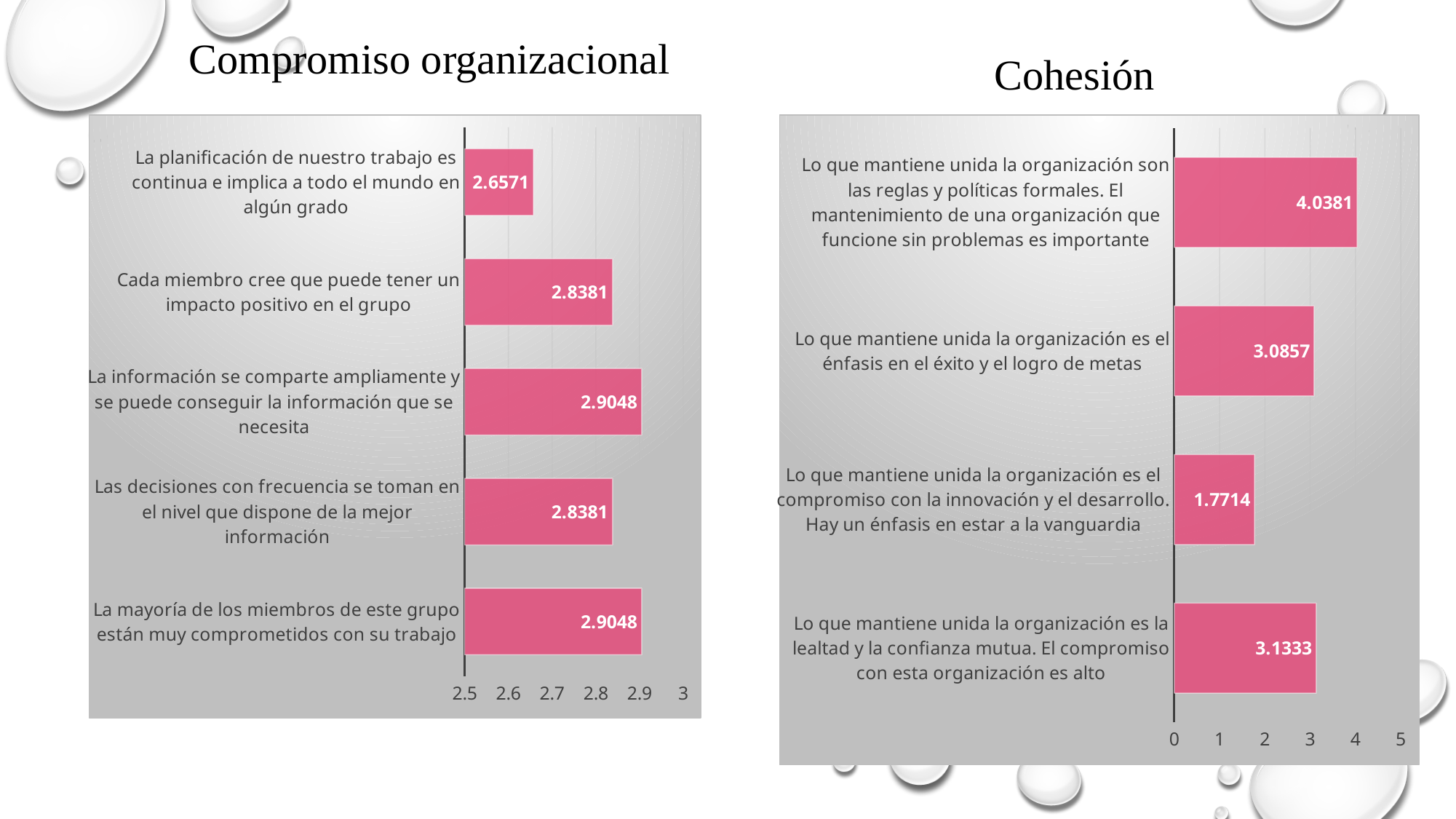
In the 'Cohesión' chart, what is the value for 'Lo que mantiene unida la organización son las reglas y políticas formales. El mantenimiento de una organización que funcione sin problemas es importante'? 4.0381 In the 'Cohesión' chart, which is larger: the value for 'Lo que mantiene unida la organización es la lealtad y la confianza mutua. El compromiso con esta organización es alto' or the value for 'Lo que mantiene unida la organización es el énfasis en el éxito y el logro de metas'? Lo que mantiene unida la organización es la lealtad y la confianza mutua. El compromiso con esta organización es alto In the 'Compromiso organizacional' chart, what is the value for 'Cada miembro cree que puede tener un impacto positivo en el grupo'? 2.8381 In the 'Cohesión' chart, how many categories are shown? 4 In the 'Cohesión' chart, which category has the highest value? Lo que mantiene unida la organización son las reglas y políticas formales. El mantenimiento de una organización que funcione sin problemas es importante In the 'Compromiso organizacional' chart, which category has the lowest value? La planificación de nuestro trabajo es continua e implica a todo el mundo en algún grado In the 'Cohesión' chart, which category has the lowest value? Lo que mantiene unida la organización es el compromiso con la innovación y el desarrollo. Hay un énfasis en estar a la vanguardia What type of chart is the 'Cohesión' chart? Bar chart In the 'Compromiso organizacional' chart, what is the value for 'La planificación de nuestro trabajo es continua e implica a todo el mundo en algún grado'? 2.6571 In the 'Cohesión' chart, what is the value for 'Lo que mantiene unida la organización es el compromiso con la innovación y el desarrollo. Hay un énfasis en estar a la vanguardia'? 1.7714 In the 'Compromiso organizacional' chart, how many categories are shown? 5 In the 'Compromiso organizacional' chart, what is the difference between the value for 'La mayoría de los miembros de este grupo están muy comprometidos con su trabajo' and the value for 'La planificación de nuestro trabajo es continua e implica a todo el mundo en algún grado'? 0.2477